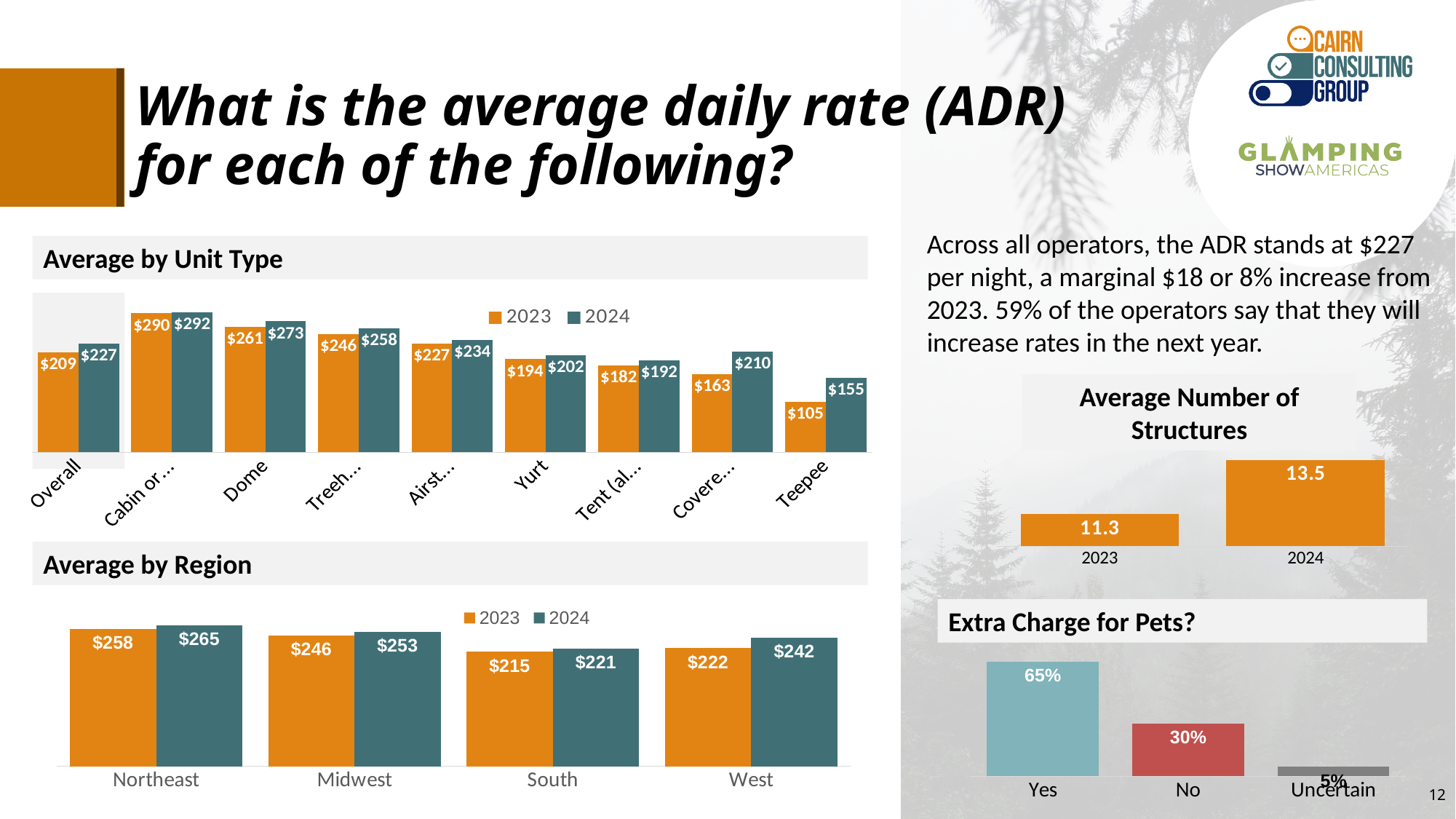
In the 'Average by Region' chart, how many regions are shown? 4 In the 'Average by Unit Type' chart, how many series does the legend list? 2 In the 'Average by Unit Type' chart, what is the 2023 value for Teepee? $105 In the 'Extra Charge for Pets?' chart, what is the value for No? 30% In the 'Average Number of Structures' chart, what is the value for 2024? 13.5 In the 'Average by Unit Type' chart, what is the difference between the 2024 and 2023 values for Yurt? $8 In the 'Average by Region' chart, what is the 2023 value for South? $215 In the 'Average by Unit Type' chart, which unit type has the lowest 2024 value? Teepee In the 'Average by Region' chart, what is the difference between the 2024 and 2023 values for West? $20 What kind of chart is the 'Extra Charge for Pets?' chart? Bar chart In the 'Average by Unit Type' chart, what is the 2024 value for Dome? $273 In the 'Average by Region' chart, which region has the highest 2024 value? Northeast